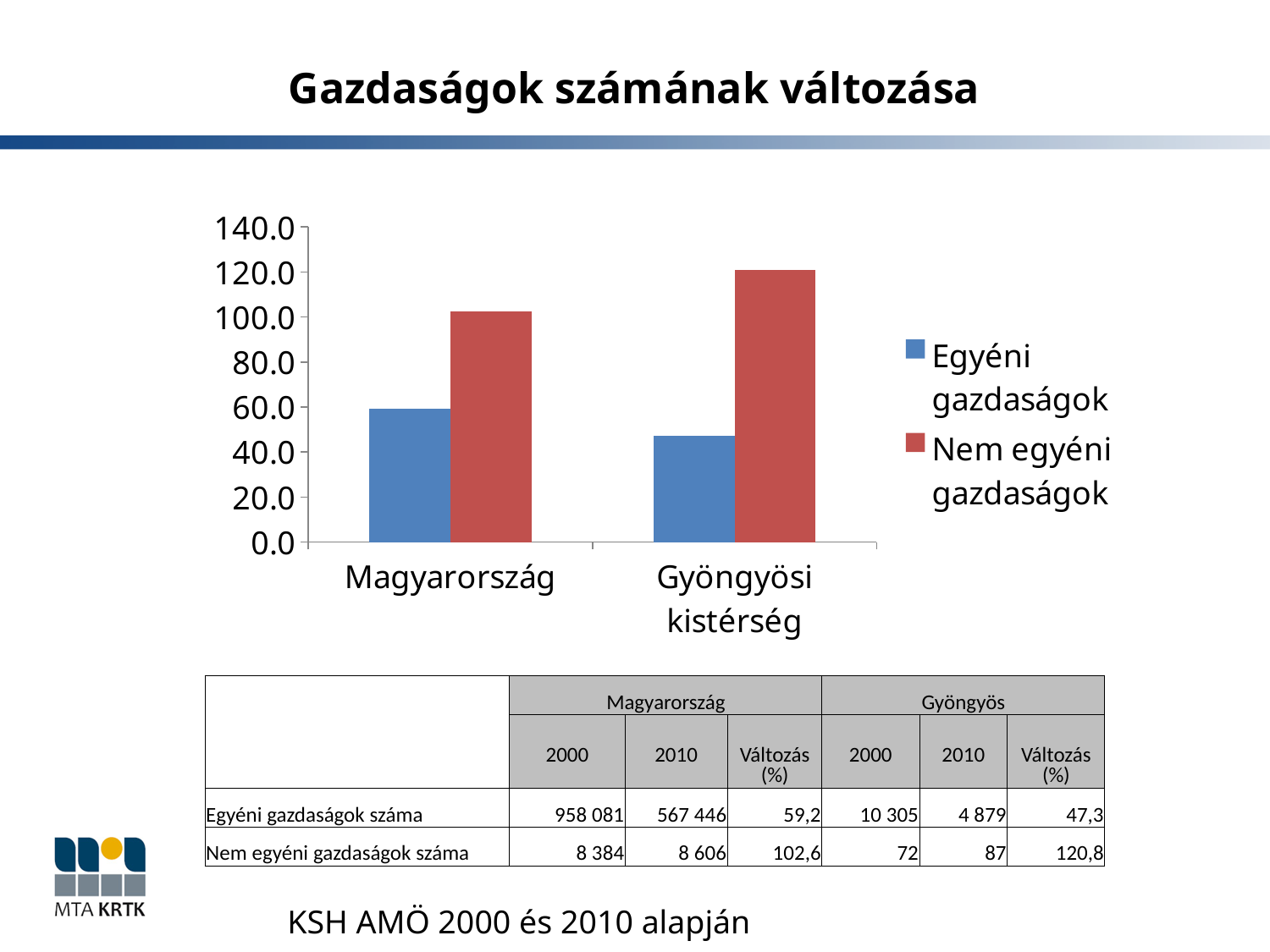
For Nem egyéni gazdaságok, which category has the larger value, Magyarország or Gyöngyösi kistérség? Gyöngyösi kistérség For Egyéni gazdaságok, which category has the larger value, Magyarország or Gyöngyösi kistérség? Magyarország Is the value for Egyéni gazdaságok in Gyöngyösi kistérség greater or less than 60? less How many categories are shown on the x axis of the chart? 2 Which bar in the chart is the highest? Nem egyéni gazdaságok for Gyöngyösi kistérség Is the value for Nem egyéni gazdaságok in Magyarország greater or less than 80? greater Which series is shown in red in the chart? Nem egyéni gazdaságok What kind of chart is shown on the slide? bar chart How many series does the chart legend list? 2 Is the value for Nem egyéni gazdaságok in Gyöngyösi kistérség greater or less than 100? greater What is the title of the slide containing the chart? Gazdaságok számának változása Which bar in the chart is the lowest? Egyéni gazdaságok for Gyöngyösi kistérség